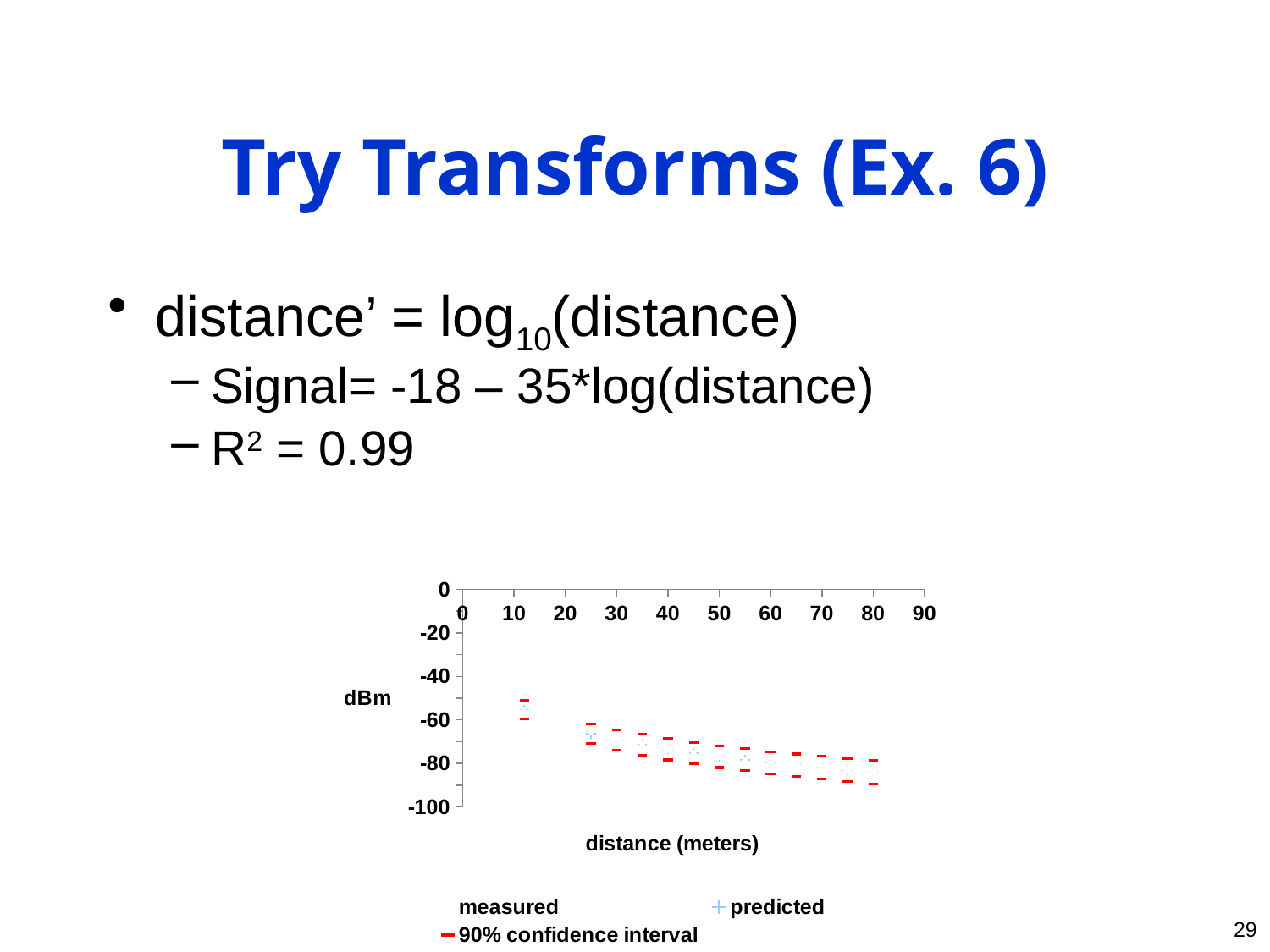
Is the measured dBm value at the smallest plotted distance (around 12 meters) greater or less than -80? greater What is the title of the x axis of the chart? distance (meters) What is the highest value shown on the x axis of the chart? 90 How many series does the chart's legend list? 3 What is the label on the y axis of the chart? dBm Which has the higher dBm value: the point at the smallest plotted distance or the point at the largest plotted distance? the point at the smallest plotted distance What kind of chart is shown on the slide? scatter chart Is the measured dBm value at the smallest plotted distance (around 12 meters) greater or less than -40? less Do the plotted dBm values rise or fall as distance increases along the x axis? fall Is the measured dBm value at the largest plotted distance (around 80 meters) greater or less than -60? less